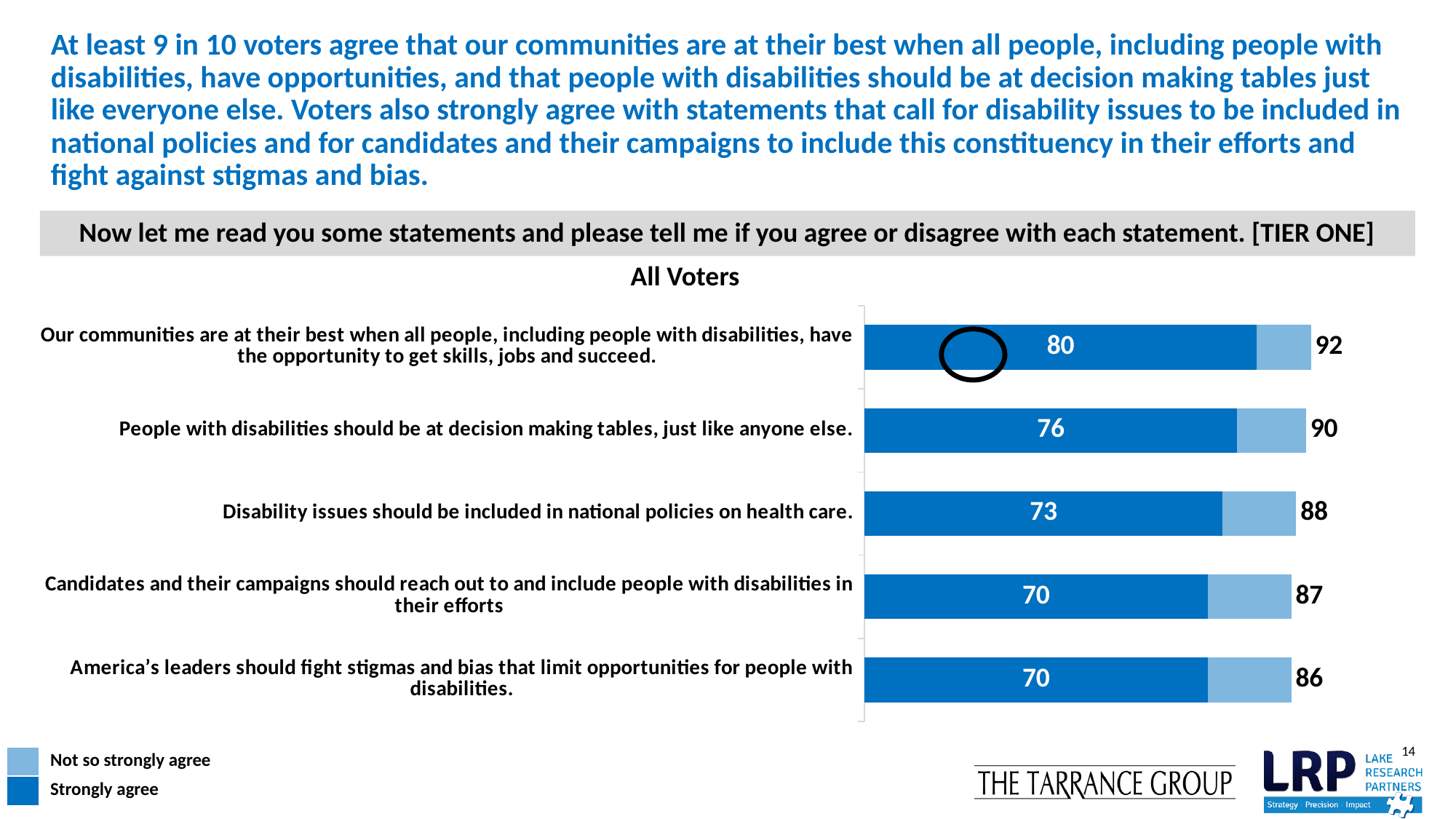
What is the 'Strongly agree' value for 'People with disabilities should be at decision making tables, just like anyone else.'? 76 What is the difference between the total agreement (92) and the 'Strongly agree' value (80) for the statement about communities being at their best? 12 How many statements are plotted in the chart? 5 Which statement has the highest 'Strongly agree' value? Our communities are at their best when all people, including people with disabilities, have the opportunity to get skills, jobs and succeed. What is the total agreement shown for 'America's leaders should fight stigmas and bias that limit opportunities for people with disabilities.'? 86 Which statement has the lowest total agreement? America's leaders should fight stigmas and bias that limit opportunities for people with disabilities. What is the total agreement shown for 'Our communities are at their best when all people, including people with disabilities, have the opportunity to get skills, jobs and succeed.'? 92 What kind of chart is shown on the slide? bar chart What is the 'Strongly agree' value for 'Disability issues should be included in national policies on health care.'? 73 How many series does the legend list? 2 What is the title of the chart? All Voters Which has a larger 'Strongly agree' value: the statement about decision making tables or the statement about national policies on health care? People with disabilities should be at decision making tables, just like anyone else.